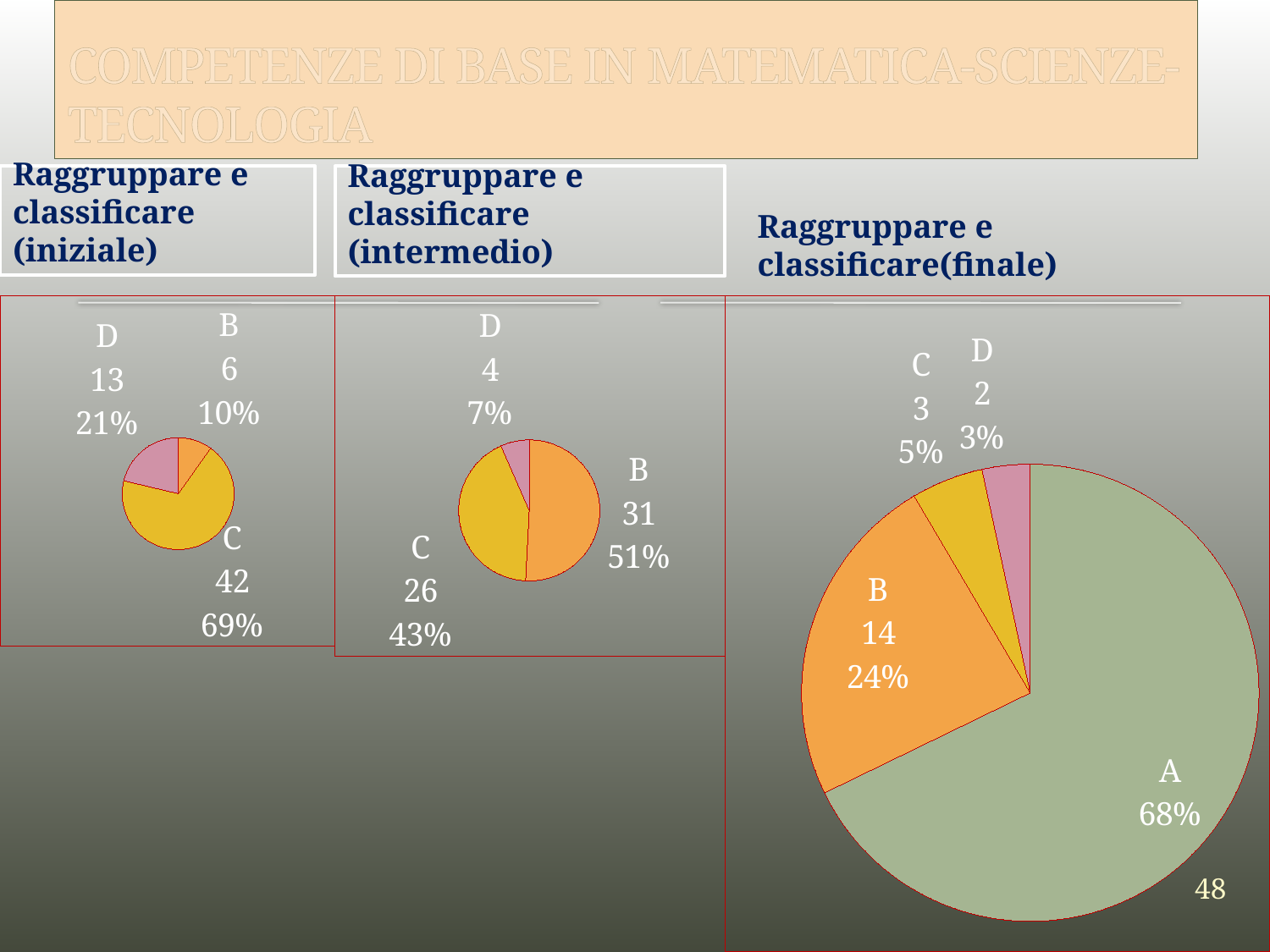
How many slices does the 'Raggruppare e classificare (iniziale)' pie chart have? 3 In the 'Raggruppare e classificare (iniziale)' pie chart, which category has the smallest slice? B In the 'Raggruppare e classificare (intermedio)' pie chart, what is the value for B? 31 In the 'Raggruppare e classificare (intermedio)' pie chart, what is the difference between the values for B and C? 5 What type of chart is used for 'Raggruppare e classificare(finale)'? Pie chart In the 'Raggruppare e classificare (intermedio)' pie chart, what percentage does slice D represent? 7% In the 'Raggruppare e classificare(finale)' pie chart, what is the value for B? 14 How many slices does the 'Raggruppare e classificare(finale)' pie chart have? 4 In the 'Raggruppare e classificare (iniziale)' pie chart, what percentage does slice C represent? 69% In the 'Raggruppare e classificare(finale)' pie chart, what percentage does slice A represent? 68% In the 'Raggruppare e classificare (iniziale)' pie chart, what is the value for D? 13 In the 'Raggruppare e classificare (intermedio)' pie chart, which category has the largest slice? B